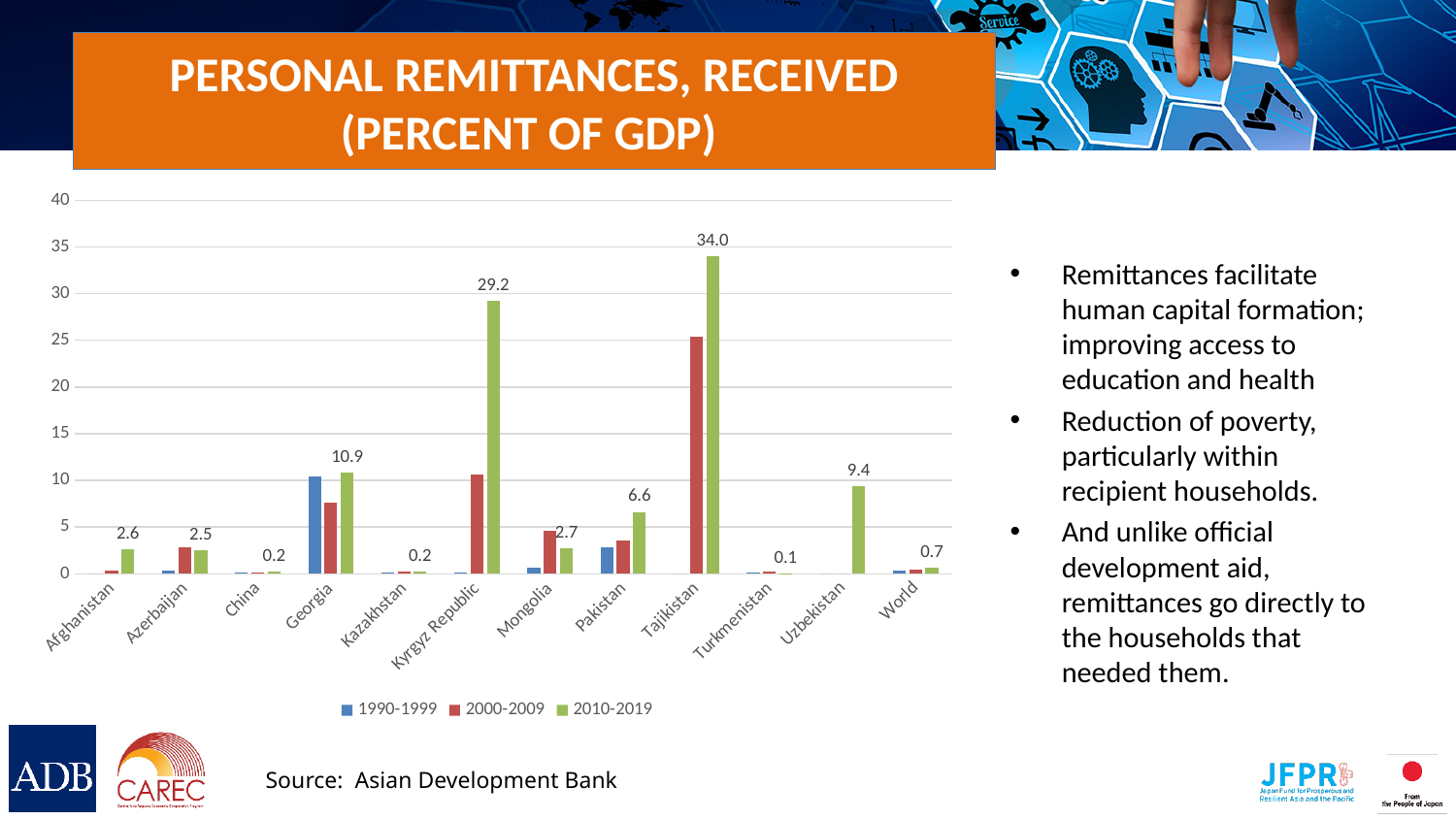
In the 2010-2019 series, which is larger: Georgia or Uzbekistan? Georgia Which category has the lowest value in the 2010-2019 series? Turkmenistan How many series does the legend list? 3 How many categories are shown on the x axis? 12 What is the value for the Kyrgyz Republic in the 2010-2019 series? 29.2 Is the value for Tajikistan in the 2000-2009 series greater or less than 20? greater Which country has the highest value in the 2010-2019 series? Tajikistan What is the difference between the 2010-2019 values for Tajikistan and the Kyrgyz Republic? 4.8 What is the value for World in the 2010-2019 series? 0.7 What is the value for Tajikistan in the 2010-2019 series? 34.0 What is the value for Uzbekistan in the 2010-2019 series? 9.4 What kind of chart is shown on the slide? Bar chart